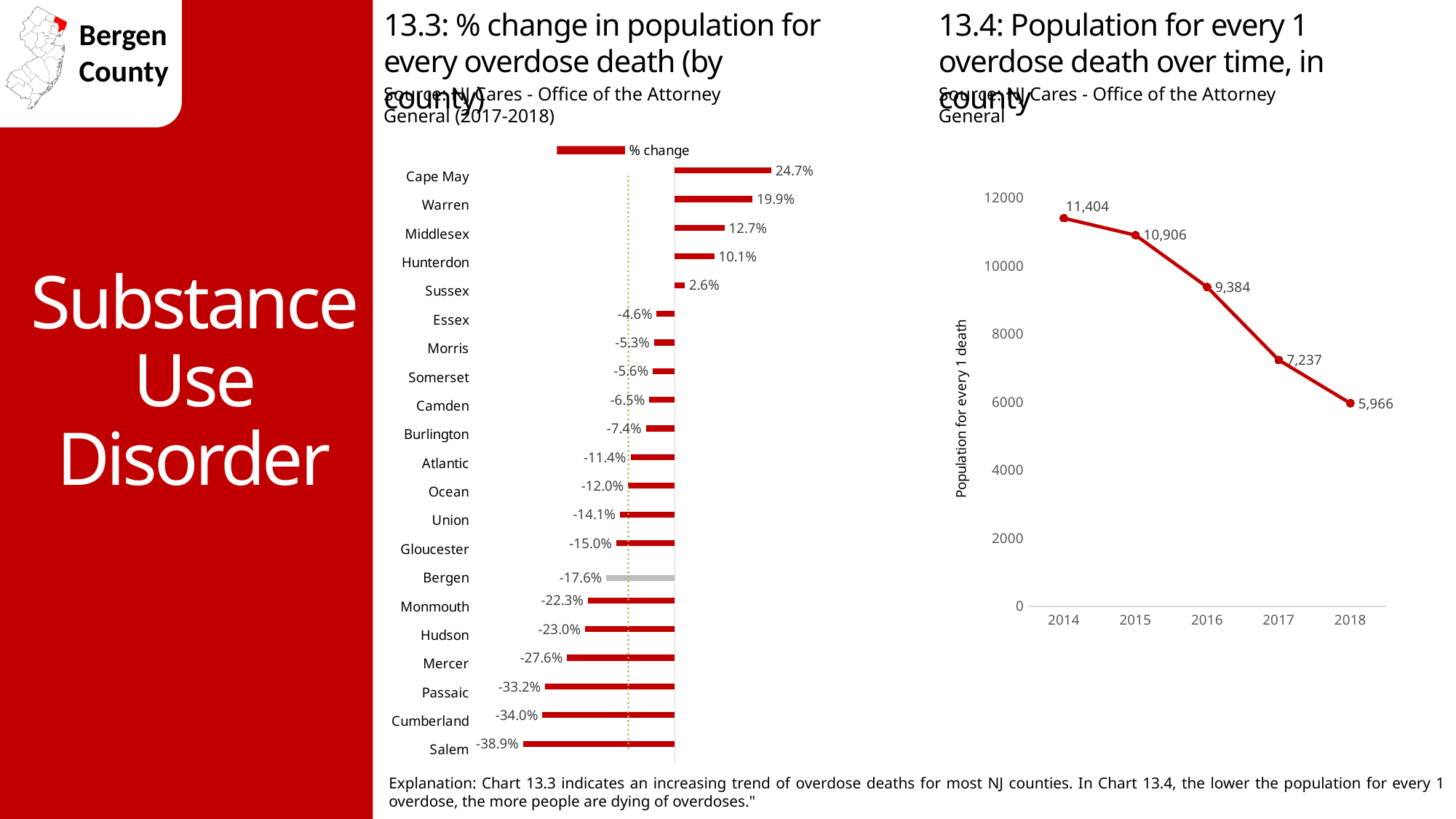
In chart 13.4, how many years are plotted? 5 In chart 13.3, which has a larger % change, Warren or Hunterdon? Warren In chart 13.3, how many counties are shown? 21 In chart 13.3, which county has the highest % change? Cape May In chart 13.3, what is the % change for Middlesex? 12.7% In chart 13.3, which county has the lowest % change? Salem What kind of chart is chart 13.3? Bar chart In chart 13.4, do the values rise or fall from 2014 to 2018? Fall In chart 13.4, what is the difference between the 2014 and 2018 values? 5,438 In chart 13.4, what is the population for every 1 overdose death in 2018? 5,966 In chart 13.3, what is the % change in population for every overdose death for Bergen? -17.6% In chart 13.4, what is the population for every 1 overdose death in 2016? 9,384